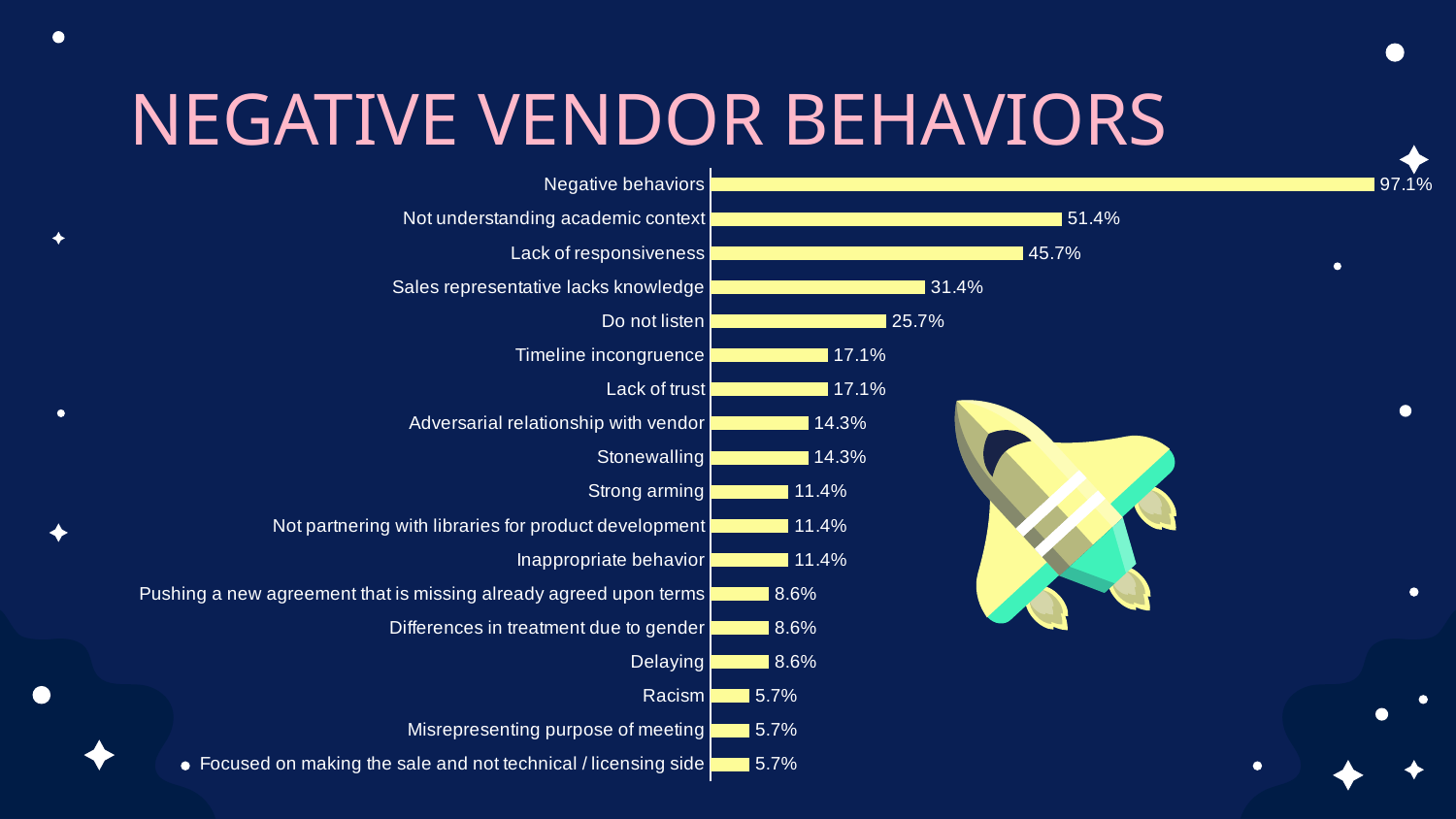
What is the difference between Negative behaviors and Not understanding academic context? 45.7% What is the value for Do not listen? 25.7% What is the difference between Not understanding academic context and Sales representative lacks knowledge? 20.0% Which is larger, Timeline incongruence or Strong arming? Timeline incongruence What kind of chart is shown on the slide? Bar chart What is the value for Stonewalling? 14.3% Which is larger, Racism or Inappropriate behavior? Inappropriate behavior Which category has the highest value? Negative behaviors How many categories are shown in the chart? 18 What is the value for Lack of responsiveness? 45.7% What is the value for Delaying? 8.6% What is the title of the slide? NEGATIVE VENDOR BEHAVIORS